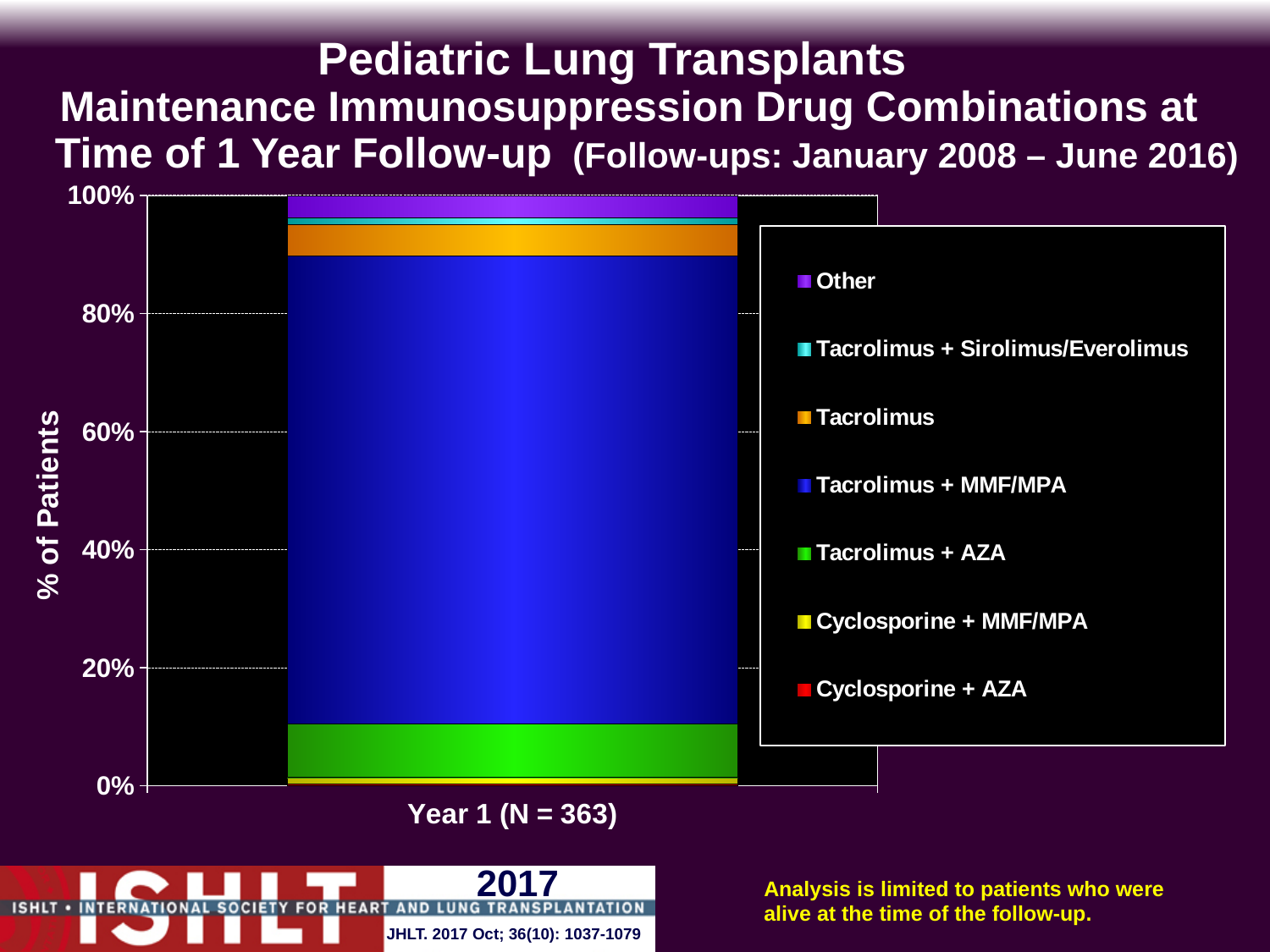
How many bars (categories) are plotted on the x axis? 1 What is the total height of the stacked Year 1 bar? 100% How many series does the legend list? 7 What is the label of the single category on the x axis? Year 1 (N = 363) Is the share for Tacrolimus (alone) in the Year 1 bar greater or less than 20%? less Which is larger in the Year 1 bar, the segment for Tacrolimus + MMF/MPA or the segment for Tacrolimus + AZA? Tacrolimus + MMF/MPA Which drug combination accounts for the largest segment of the Year 1 bar? Tacrolimus + MMF/MPA Is the share for Tacrolimus + MMF/MPA in the Year 1 bar greater or less than 60%? greater Which is larger in the Year 1 bar, the segment for Tacrolimus + AZA or the segment for Other? Tacrolimus + AZA What kind of chart is shown on the slide? Stacked bar chart Is the share for Tacrolimus + AZA in the Year 1 bar greater or less than 20%? less What is the label of the y axis? % of Patients